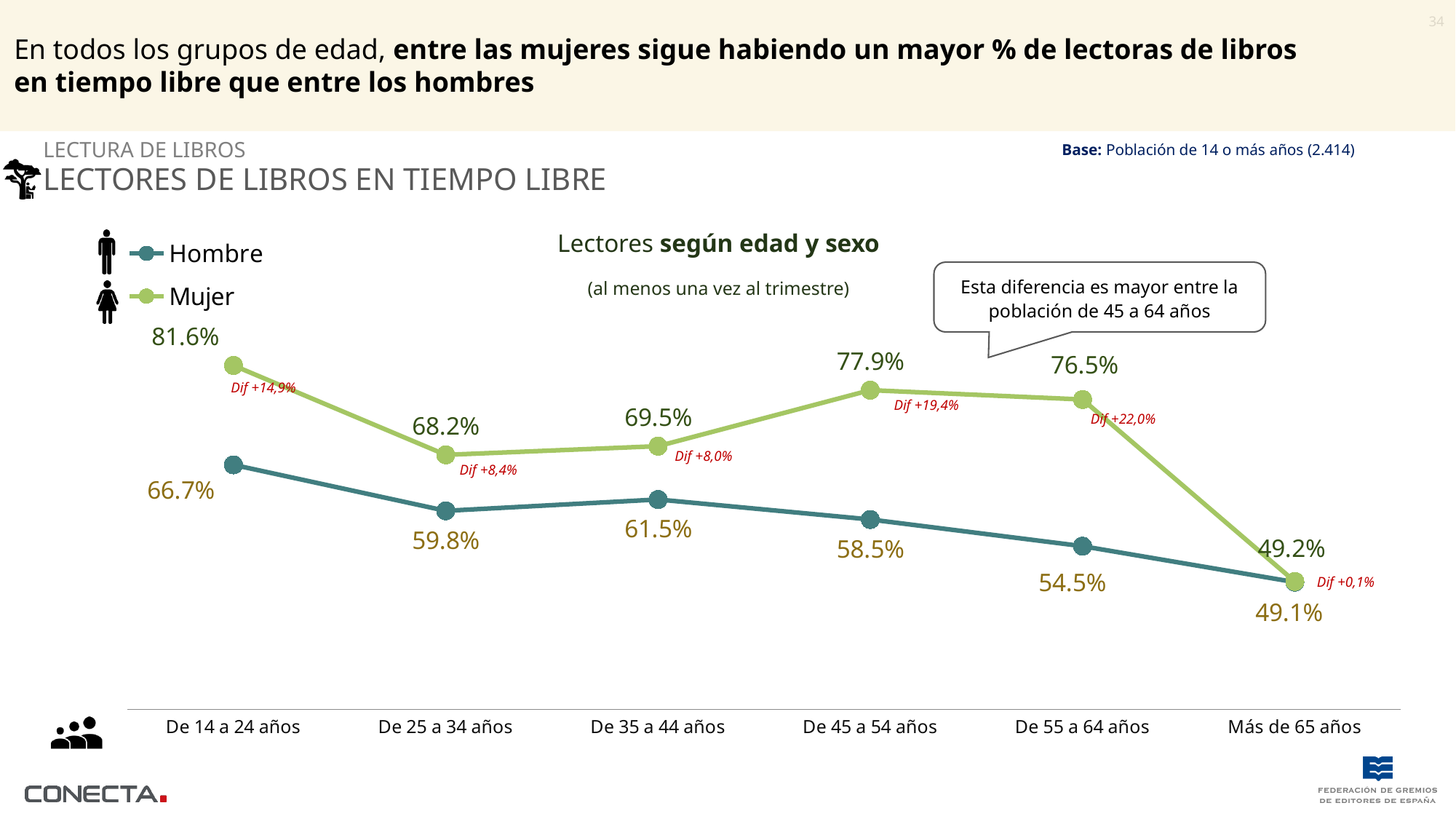
Which is larger in the 'De 25 a 34 años' age group, the Hombre value or the Mujer value? Mujer What is the value for Hombre in the 'De 35 a 44 años' age group? 61.5% What is the value for Mujer in the 'De 14 a 24 años' age group? 81.6% What is the difference between the Mujer and Hombre values in the 'De 45 a 54 años' age group? 19.4% Which age group has the highest value for Mujer? De 14 a 24 años What is the title of the chart? Lectores según edad y sexo What is the value for Hombre in the 'De 55 a 64 años' age group? 54.5% How many age groups are shown on the x axis? 6 Which age group has the lowest value for Hombre? Más de 65 años What kind of chart is shown on the slide? Line chart Does the Hombre series rise or fall from 'De 35 a 44 años' to 'Más de 65 años'? Fall How many series does the legend list? 2